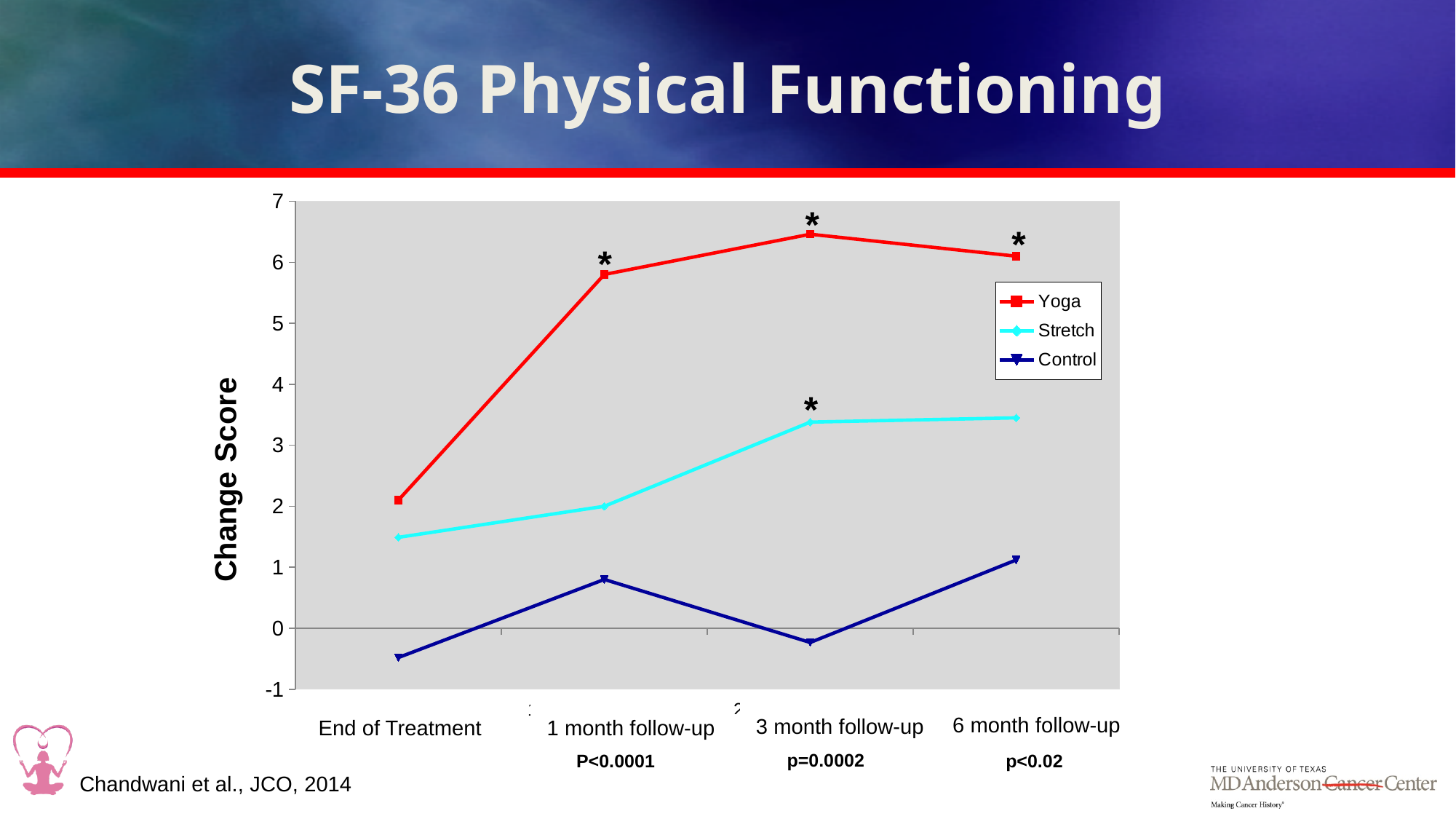
Does the Stretch series rise or fall from End of Treatment to 6 month follow-up? rise How many series does the legend list? 3 Is the Control value at 3 month follow-up greater or less than 0? less Which series has the highest value at End of Treatment? Yoga How many time points are plotted along the x axis? 4 At which time point does the Yoga series reach its highest value? 3 month follow-up What kind of chart is shown on the slide? line chart Is the Yoga value at 3 month follow-up greater or less than 6? greater At 6 month follow-up, which is larger: the Yoga value or the Stretch value? Yoga Is the Stretch value at End of Treatment greater or less than 2? less What is the label on the y axis? Change Score At which time point is the Control series at its lowest value? End of Treatment